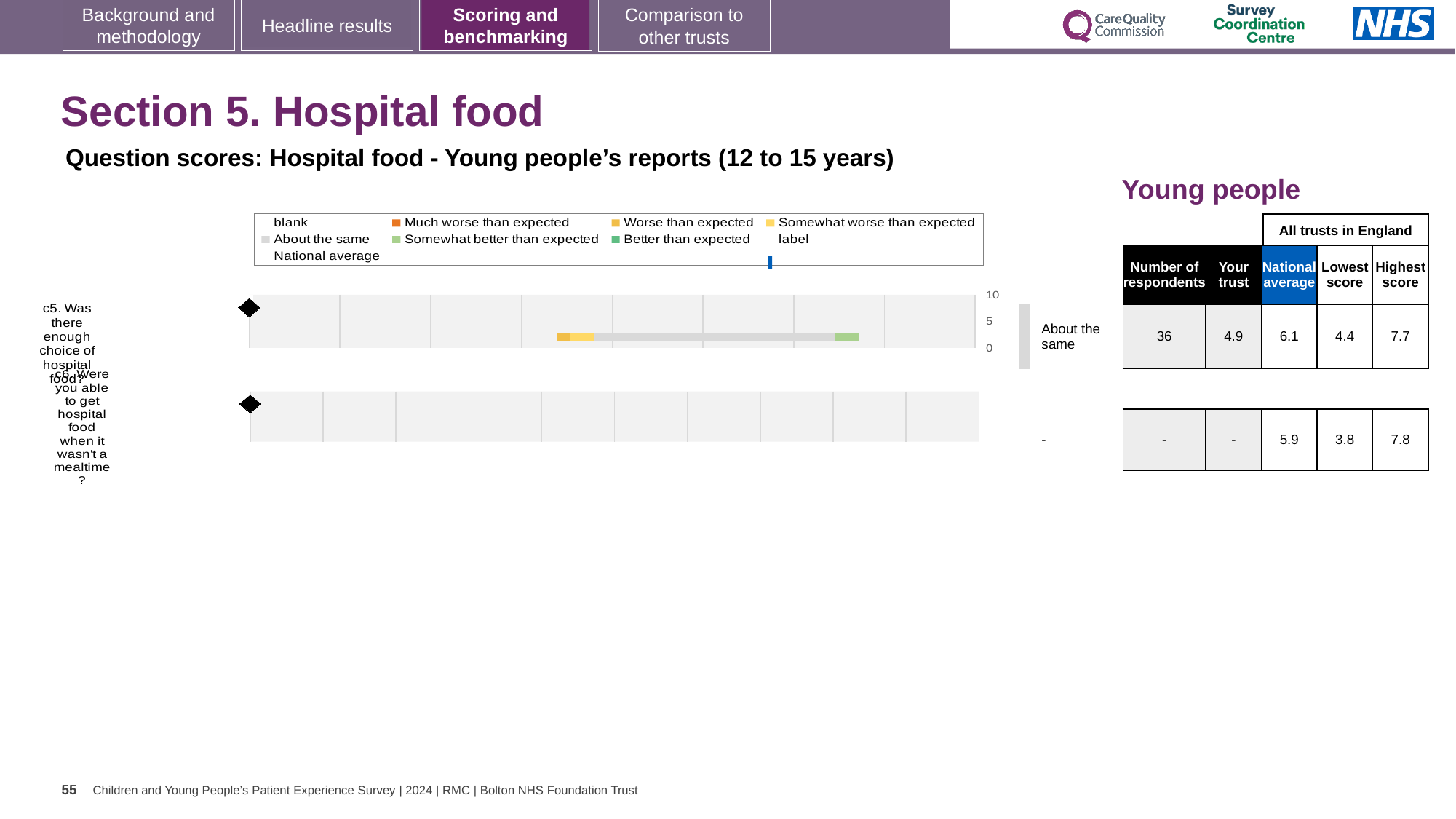
What is the maximum value shown on the chart's score axis? 10 What benchmark category is shown next to the c5 bar? About the same What kind of chart is shown on the slide? bar chart What is the lowest score across all trusts in England for c6? 3.8 According to the table, what is the 'Your trust' score for c5 (Was there enough choice of hospital food?)? 4.9 According to the table, what is the national average score for c5? 6.1 For c5, what is the difference between the national average (6.1) and the 'Your trust' score (4.9)? 1.2 For c5, which is larger: the 'Your trust' score or the national average? National average How many respondents are listed for c5 in the table? 36 What is the highest score across all trusts in England for c6 (Were you able to get hospital food when it wasn't a mealtime?)? 7.8 How many questions (categories) are plotted on the chart? 2